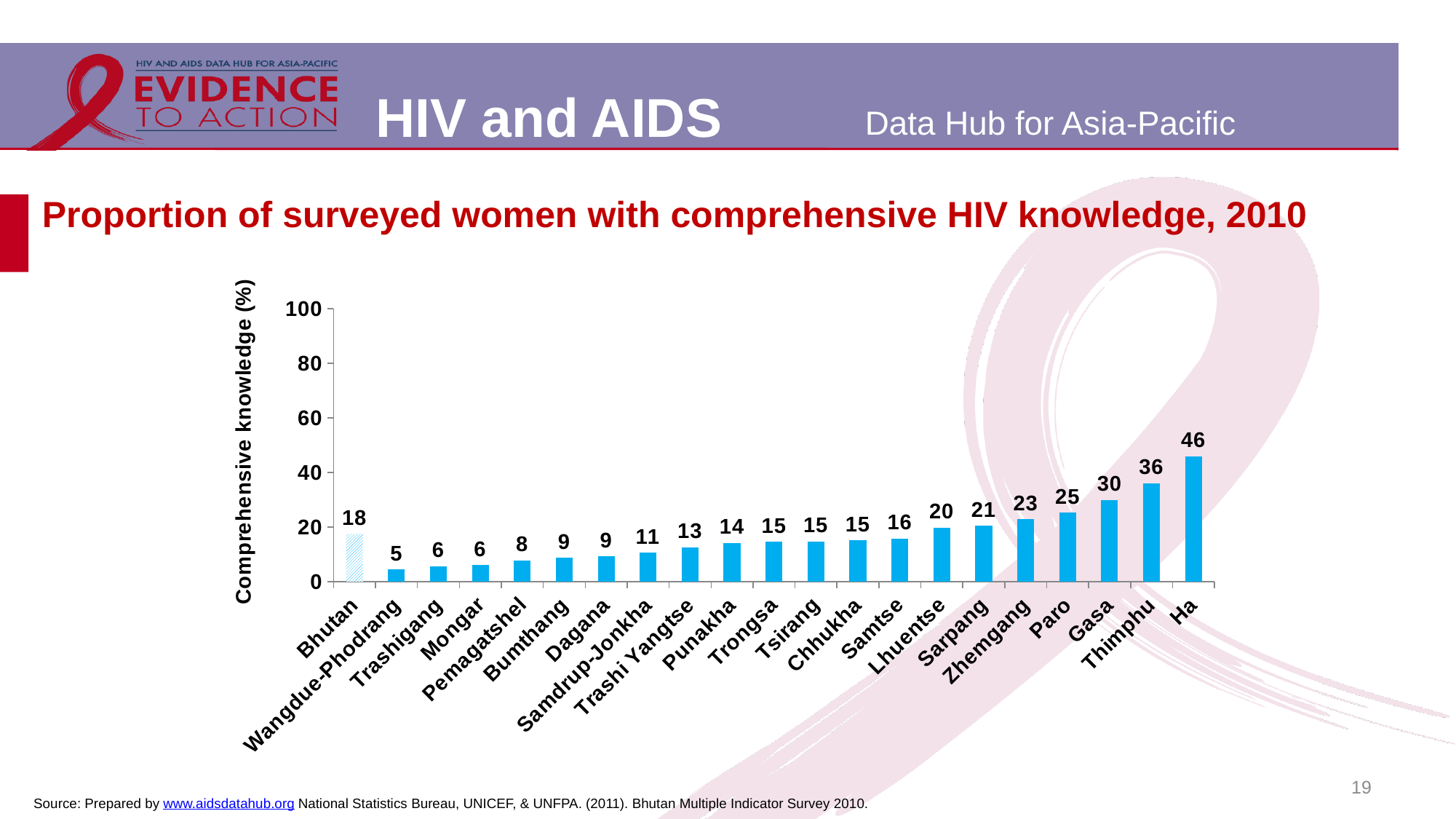
Which district has the lowest value? Wangdue-Phodrang Which has a larger value, Gasa or Paro? Gasa Do the values generally rise or fall from left to right after the Bhutan bar? Rise What is the value for Bhutan? 18 What is the value for Ha? 46 What kind of chart is this? Bar chart How many categories are shown on the x axis? 21 Which district has the highest value? Ha What is the value for Thimphu? 36 What is the difference between the values for Ha and Thimphu? 10 What is the label of the y axis? Comprehensive knowledge (%) Is the value for Ha greater or less than 40? greater